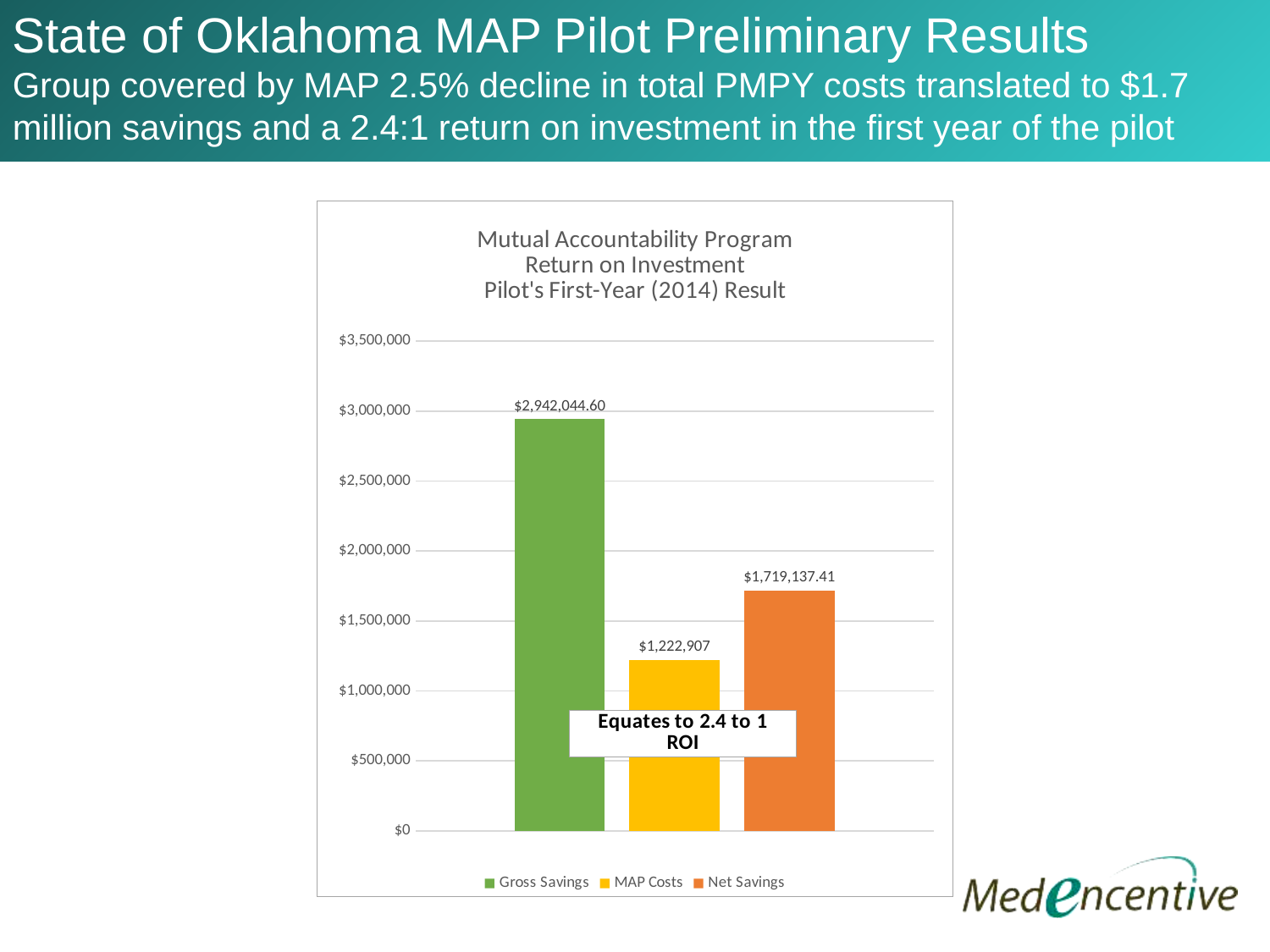
Is the value for Gross Savings greater or less than $3,000,000? less What type of chart is shown on the slide? Bar chart What is the value of the Net Savings bar? $1,719,137.41 How many series does the legend list? 3 What is the value of the MAP Costs bar? $1,222,907 Which bar has the lowest value? MAP Costs What is the difference between Net Savings and MAP Costs? $496,230.41 Which bar has the highest value? Gross Savings How many bars are plotted in the chart? 3 Is the value for MAP Costs greater or less than $1,500,000? less Which is larger, Net Savings or MAP Costs? Net Savings What is the value of the Gross Savings bar? $2,942,044.60